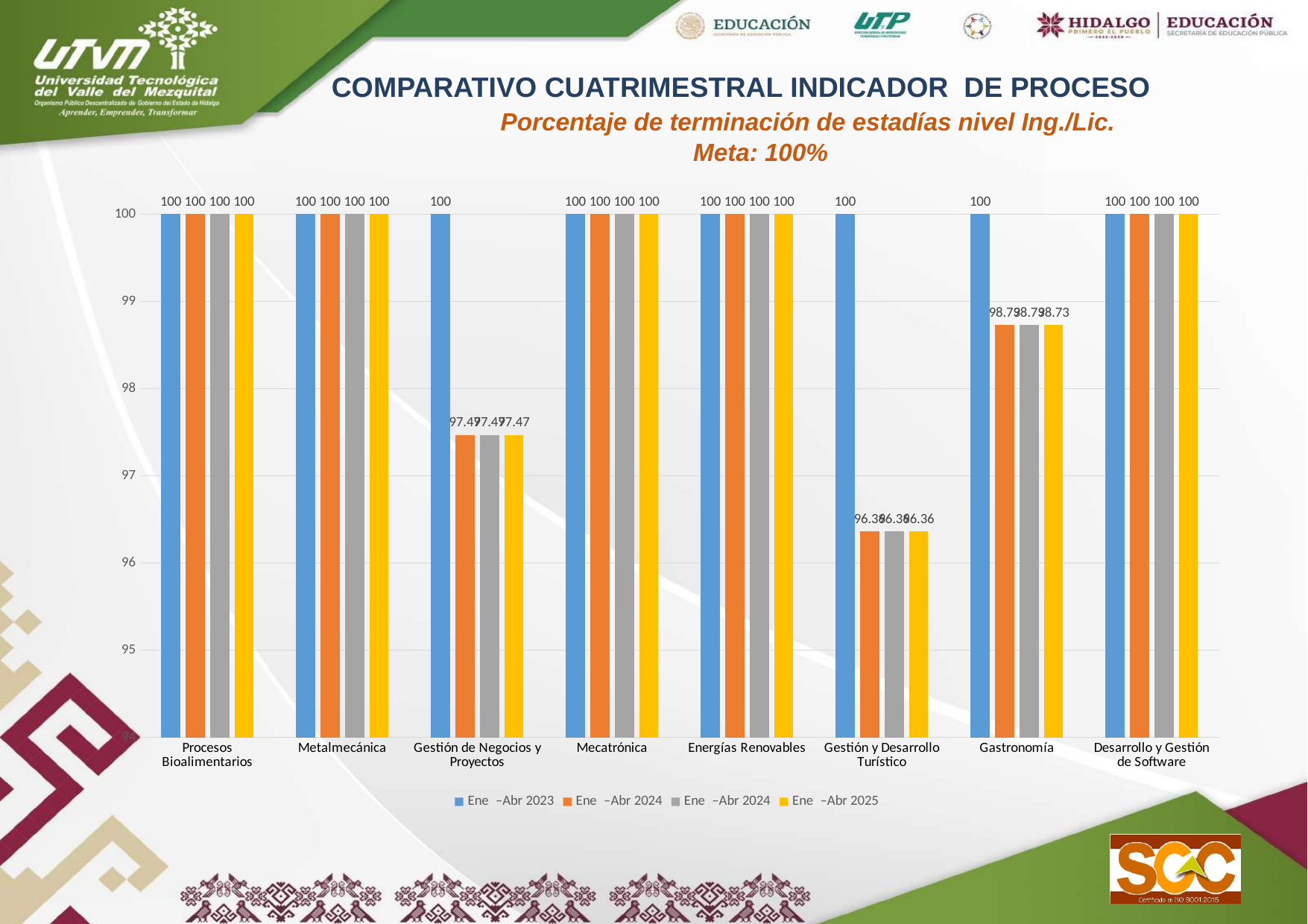
What is the value for Gestión y Desarrollo Turístico in the Ene –Abr 2025 series? 96.36 Which is larger in the Ene –Abr 2025 series: Gastronomía or Gestión de Negocios y Proyectos? Gastronomía What is the value for Gestión de Negocios y Proyectos in the Ene –Abr 2025 series? 97.47 Which category has the lowest value in the Ene –Abr 2025 series? Gestión y Desarrollo Turístico What is the value for Gastronomía in the Ene –Abr 2025 series? 98.73 What is the difference between the Ene –Abr 2025 values for Gestión de Negocios y Proyectos and Gestión y Desarrollo Turístico? 1.11 How many categories (programs) are shown on the x axis? 8 What is the value for Mecatrónica in the Ene –Abr 2023 series? 100 What kind of chart is shown on the slide? Bar chart How many series does the legend list? 4 Is the Ene –Abr 2025 value for Gestión y Desarrollo Turístico greater or less than 97? less What is the difference between the Ene –Abr 2023 value and the Ene –Abr 2025 value for Gastronomía? 1.27